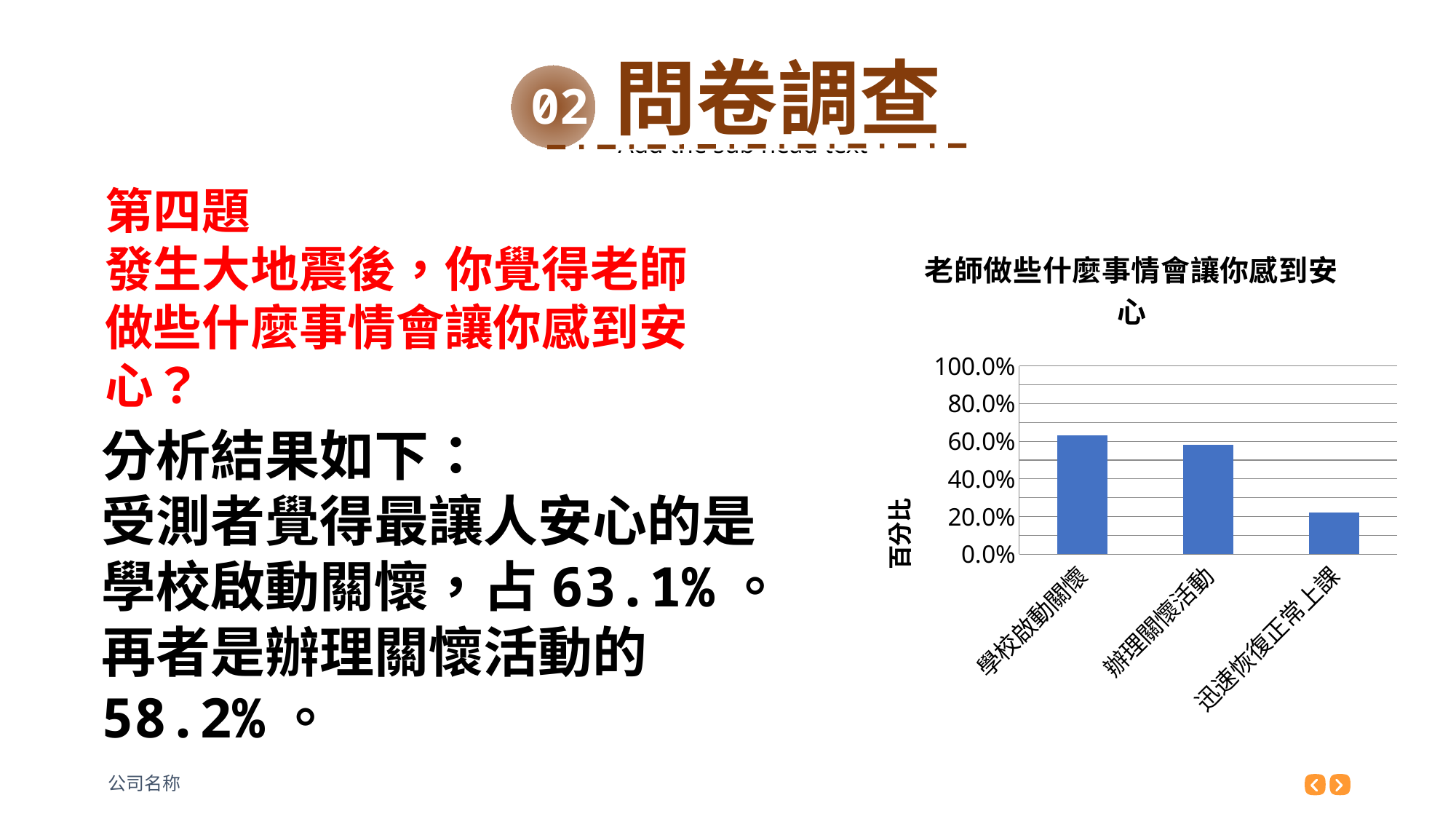
Do the values rise or fall from left to right along the x axis? fall Which is larger, the value for 辦理關懷活動 or the value for 迅速恢復正常上課? 辦理關懷活動 What is the difference between the values for 學校啟動關懷 and 辦理關懷活動? 4.9% What is the label on the vertical axis of the chart? 百分比 Is the value for 學校啟動關懷 greater or less than 60.0%? greater What is the value for 辦理關懷活動? 58.2% Which category has the lowest value in the chart? 迅速恢復正常上課 Which category has the highest value in the chart? 學校啟動關懷 What kind of chart is shown on the slide? bar chart How many categories are shown on the x axis of the chart? 3 Is the value for 迅速恢復正常上課 greater or less than 40.0%? less What is the value for 學校啟動關懷? 63.1%